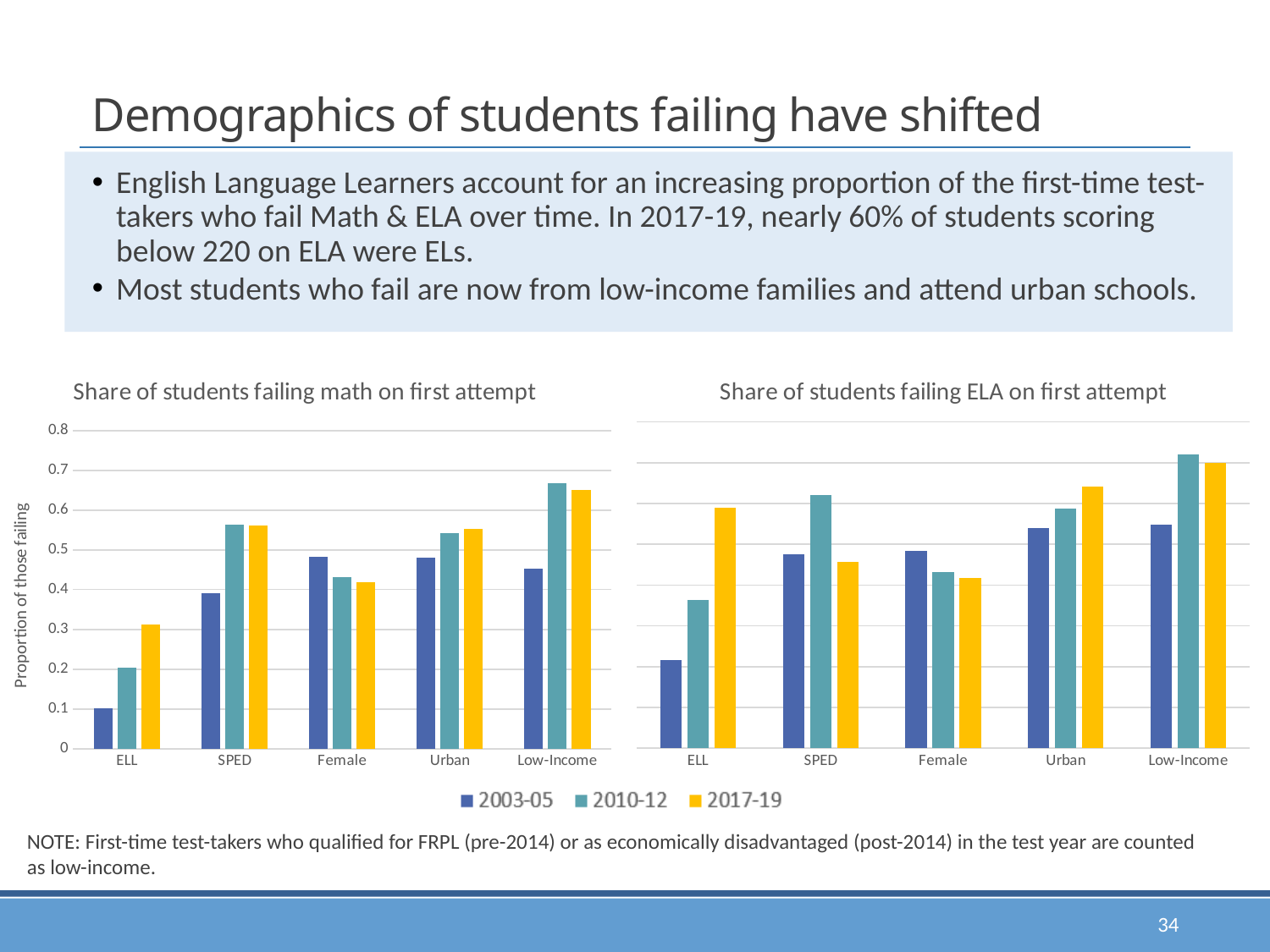
In the 'Share of students failing math on first attempt' chart, which category has the lowest 2003-05 bar? ELL What kind of chart is the 'Share of students failing math on first attempt' chart? bar chart How many series does the shared legend list for the two charts? 3 In the 'Share of students failing ELA on first attempt' chart, do the ELL values rise or fall from 2003-05 to 2017-19? rise How many categories are shown on the x axis of the 'Share of students failing ELA on first attempt' chart? 5 In the 'Share of students failing math on first attempt' chart, is the 2010-12 value for Low-Income greater or less than 0.6? greater In the 'Share of students failing math on first attempt' chart, is the 2017-19 value for ELL greater or less than 0.4? less In the 'Share of students failing ELA on first attempt' chart, is the 2003-05 value for ELL greater or less than 0.3? less In the 'Share of students failing math on first attempt' chart, which is larger for ELL: the 2003-05 value or the 2017-19 value? 2017-19 In the 'Share of students failing ELA on first attempt' chart, which category has the highest 2010-12 bar? Low-Income What is the label on the vertical axis of the left chart? Proportion of those failing